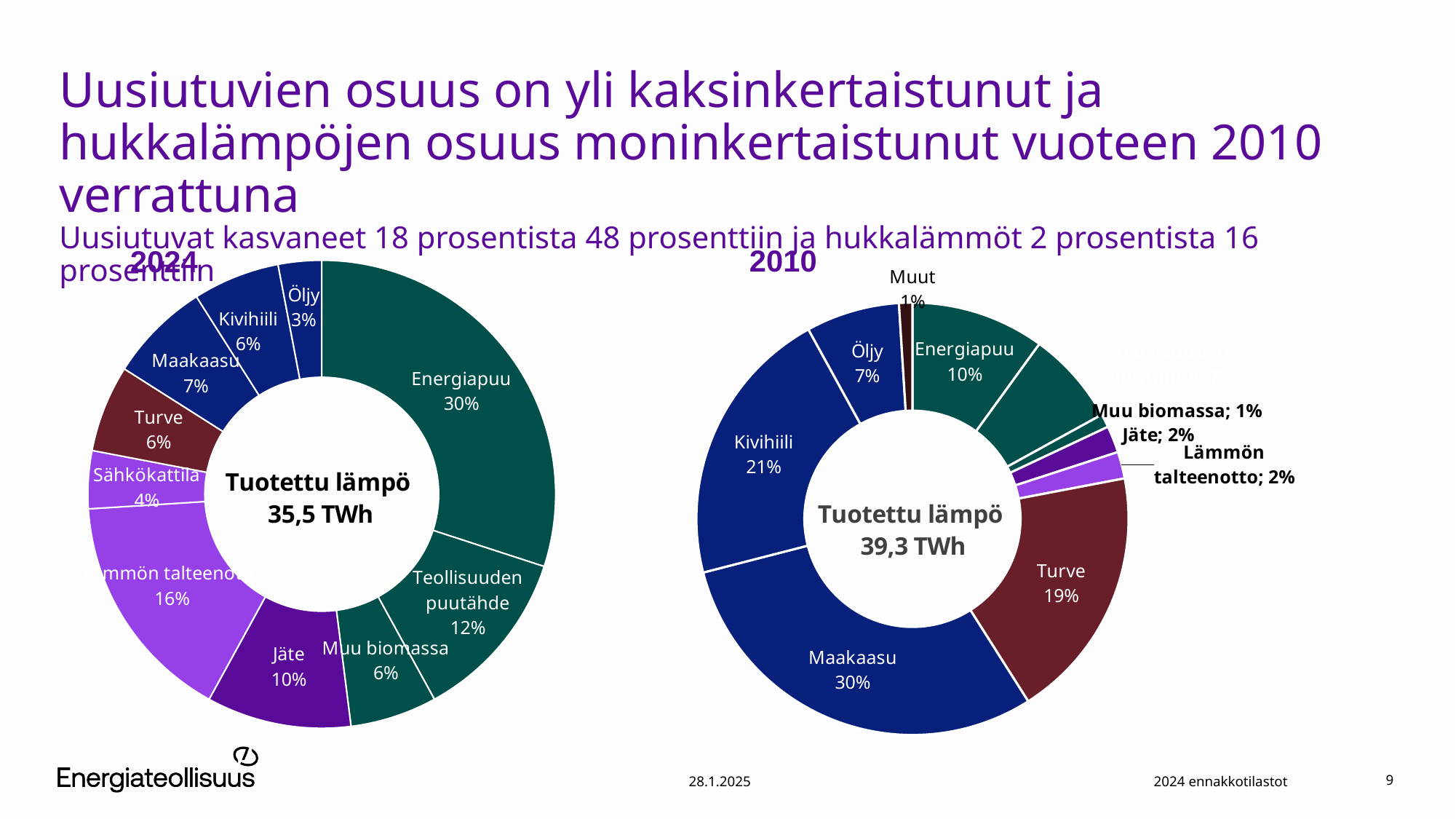
In the 2024 chart, which category has the smallest share? Öljy In the 2010 chart, which is larger, the share of Kivihiili or the share of Öljy? Kivihiili What is the total produced heat shown in the centre of the 2010 chart? 39,3 TWh What type of chart is used for the 2024 data? Donut (pie) chart In the 2024 chart, what share does Lämmön talteenotto have? 16% What is the total produced heat shown in the centre of the 2024 chart? 35,5 TWh In the 2024 chart, what share does Energiapuu have? 30% In the 2010 chart, what share does Maakaasu have? 30% In the 2010 chart, what share does Turve have? 19% In the 2010 chart, what is the difference between the shares of Kivihiili and Energiapuu? 11 percentage points In the 2010 chart, which category has the largest share? Maakaasu In the 2024 chart, what is the difference between the shares of Energiapuu and Jäte? 20 percentage points